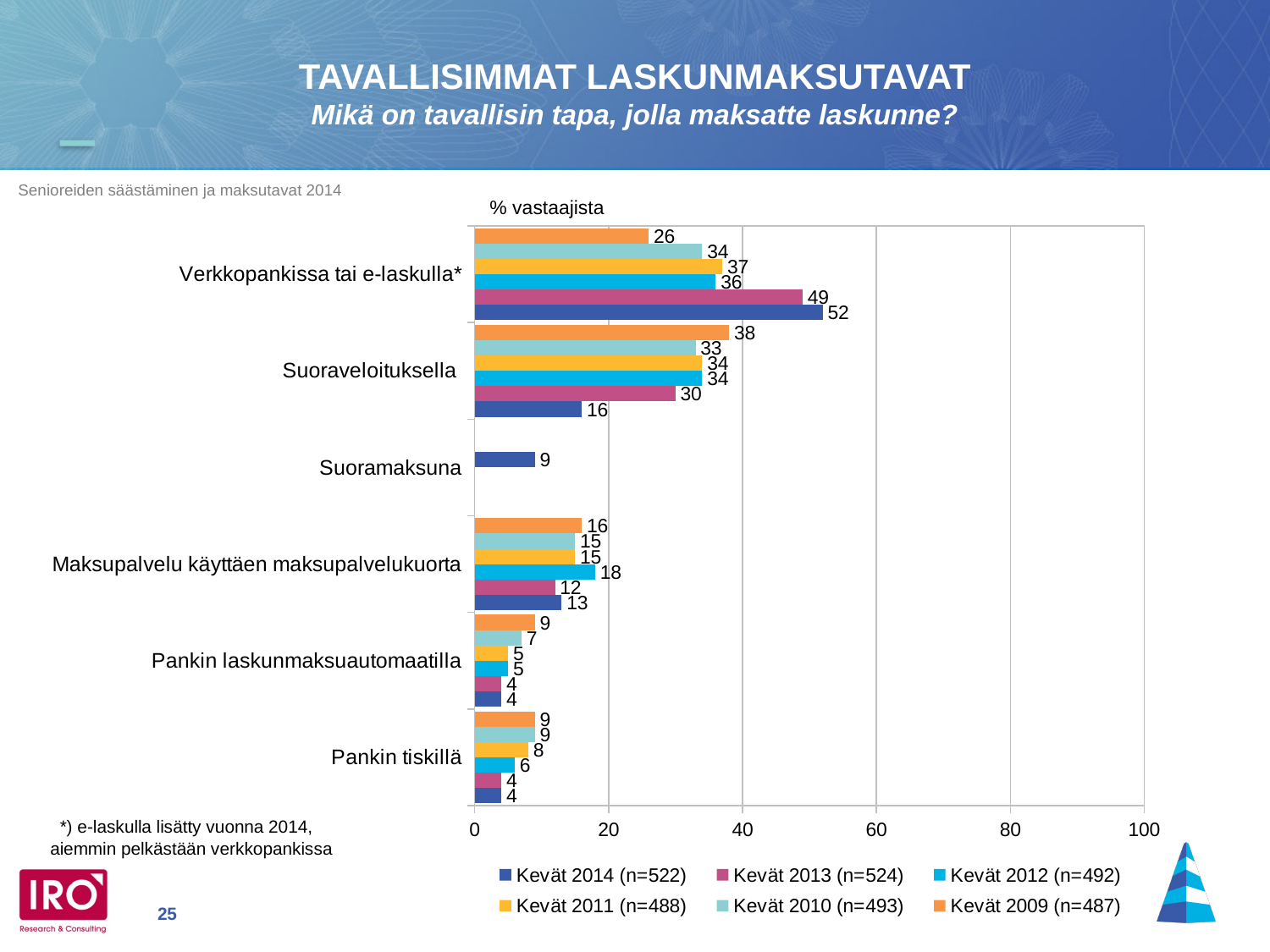
What is the value for Maksupalvelu käyttäen maksupalvelukuorta in the Kevät 2012 (n=492) series? 18 Is the Kevät 2013 (n=524) value for Verkkopankissa tai e-laskulla* greater or less than 40? greater What kind of chart is shown on the slide? bar chart What is the difference between the Kevät 2014 and Kevät 2009 values for Verkkopankissa tai e-laskulla*? 26 How many series does the legend list? 6 What is the value for Suoramaksuna in the Kevät 2014 (n=522) series? 9 What is the label on the x axis of the chart? % vastaajista Which is larger for Suoraveloituksella: the Kevät 2013 (n=524) value or the Kevät 2014 (n=522) value? Kevät 2013 (n=524) What is the value for Verkkopankissa tai e-laskulla* in the Kevät 2014 (n=522) series? 52 What is the value for Suoraveloituksella in the Kevät 2009 (n=487) series? 38 How many payment-method categories are shown on the y axis? 6 Which category has the highest value in the Kevät 2014 (n=522) series? Verkkopankissa tai e-laskulla*